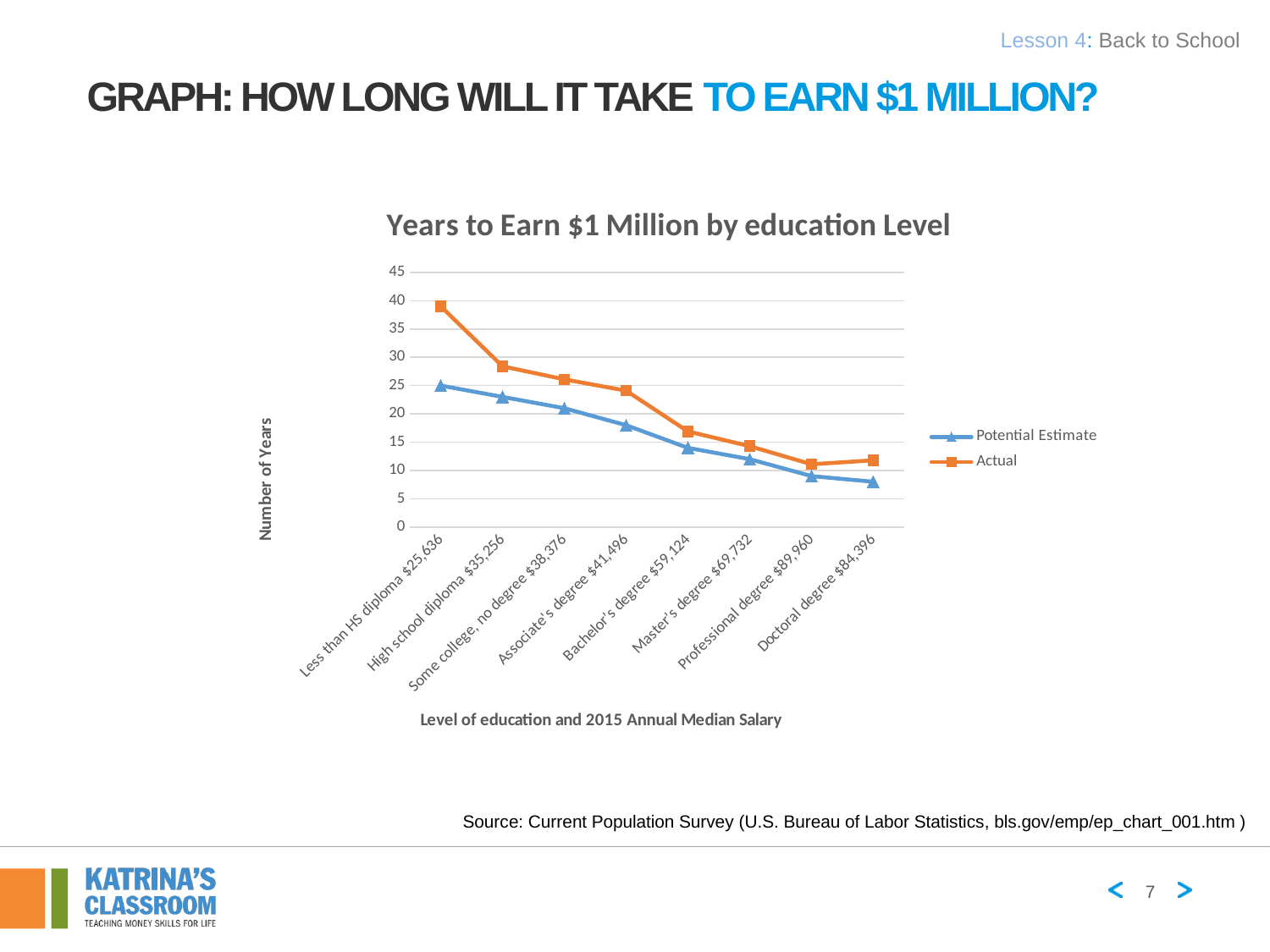
Which education level has the highest Actual value? Less than HS diploma $25,636 Is the Actual value for Bachelor's degree $59,124 greater or less than 15? greater Which education level has the lowest Potential Estimate value? Doctoral degree $84,396 What kind of chart is shown on the slide? line chart What is the title of the chart? Years to Earn $1 Million by education Level Is the Potential Estimate value for Doctoral degree $84,396 greater or less than 10? less How many series does the legend list? 2 For High school diploma $35,256, which is larger: the Actual value or the Potential Estimate value? Actual Is the Potential Estimate value for Bachelor's degree $59,124 greater or less than 15? less How many education levels are plotted along the x axis? 8 Which series is shown in orange with square markers? Actual